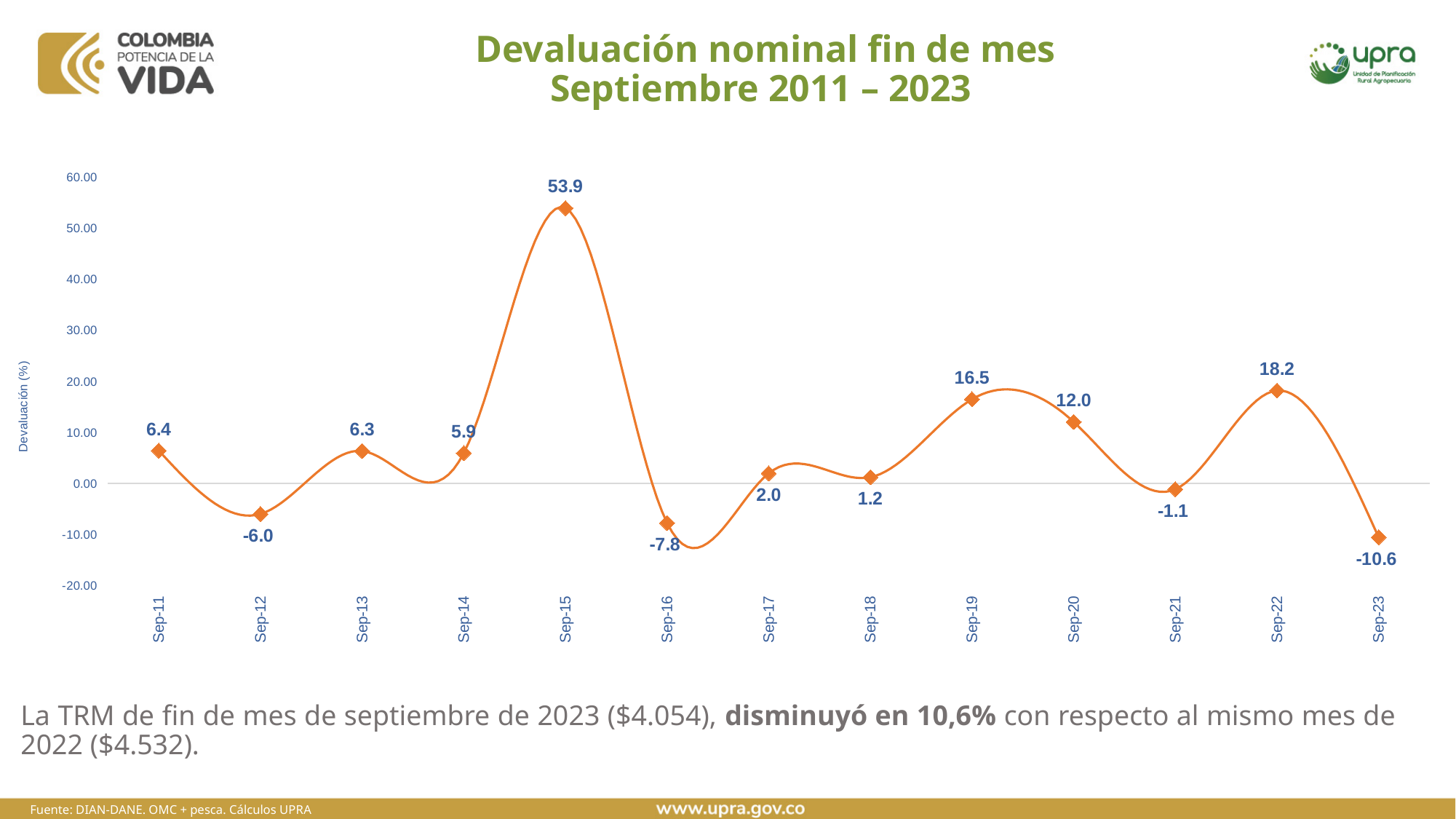
Which month has the highest devaluation value? Sep-15 Which is larger, the value for Sep-11 or the value for Sep-13? Sep-11 What is the devaluation value for Sep-23? -10.6 How many data points are plotted on the chart? 13 What is the difference between the values for Sep-22 and Sep-20? 6.2 What is the devaluation value for Sep-19? 16.5 Which month has the lowest devaluation value? Sep-23 Do the values rise or fall from Sep-22 to Sep-23? fall What is the devaluation value for Sep-15? 53.9 What is the label of the vertical axis? Devaluación (%) What kind of chart is shown on the slide? line chart Is the value for Sep-15 greater or less than 50.00? greater